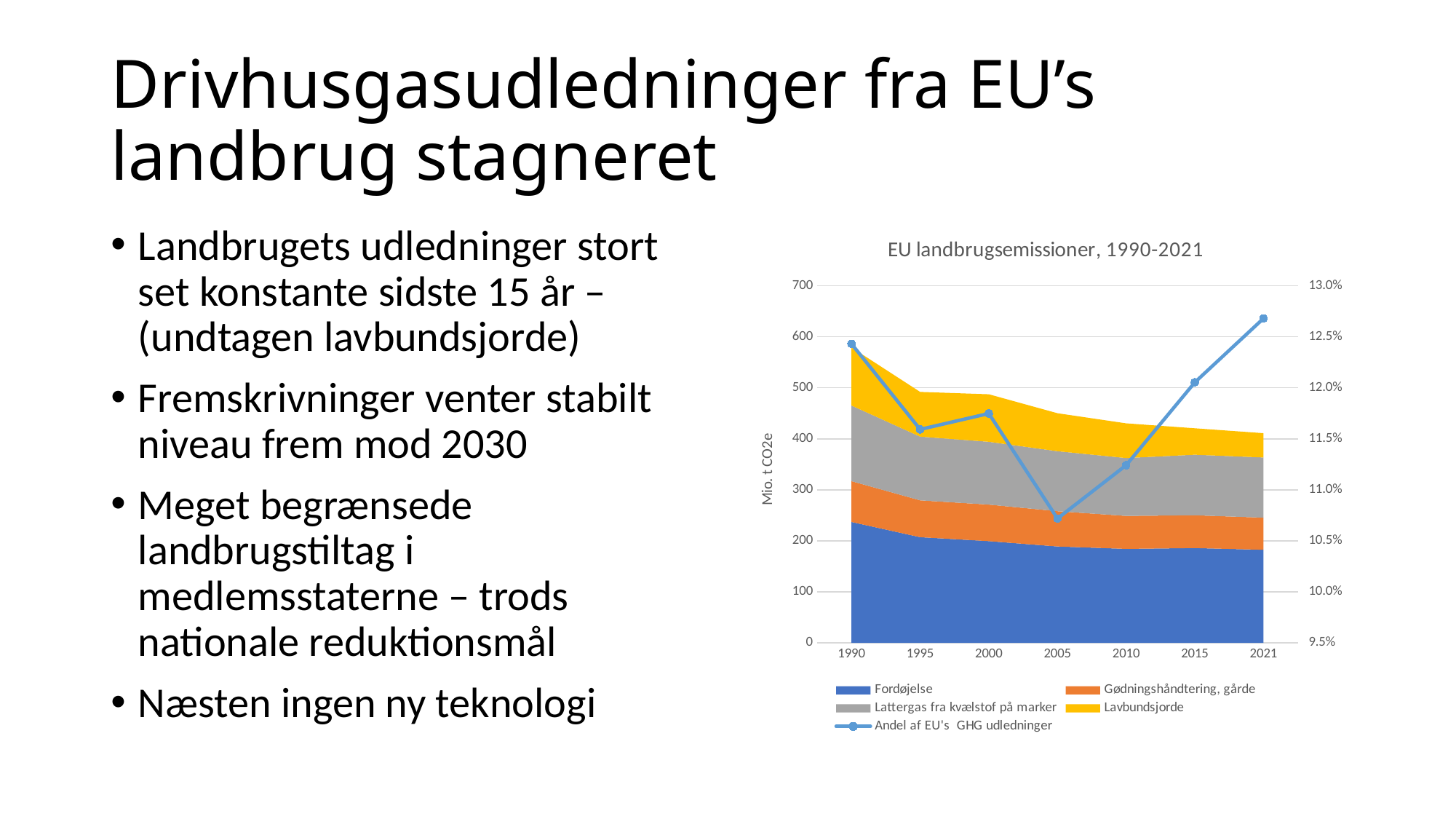
What is the label of the left vertical axis? Mio. t CO2e How many years are labelled on the x axis of the chart? 7 Is the value of 'Andel af EU's GHG udledninger' in 2021 greater or less than 12.5%? greater What kind of chart is shown on the slide? Stacked area chart with a line Is the value of 'Andel af EU's GHG udledninger' in 2005 greater or less than 11.0%? less Is the total stacked emissions value in 1990 greater or less than 500? greater Does the total stacked emissions value rise or fall from 1990 to 2021? fall How many series does the chart legend list? 5 What is the title of the chart? EU landbrugsemissioner, 1990-2021 In which year is the line 'Andel af EU's GHG udledninger' at its lowest? 2005 In which year is the line 'Andel af EU's GHG udledninger' at its highest? 2021